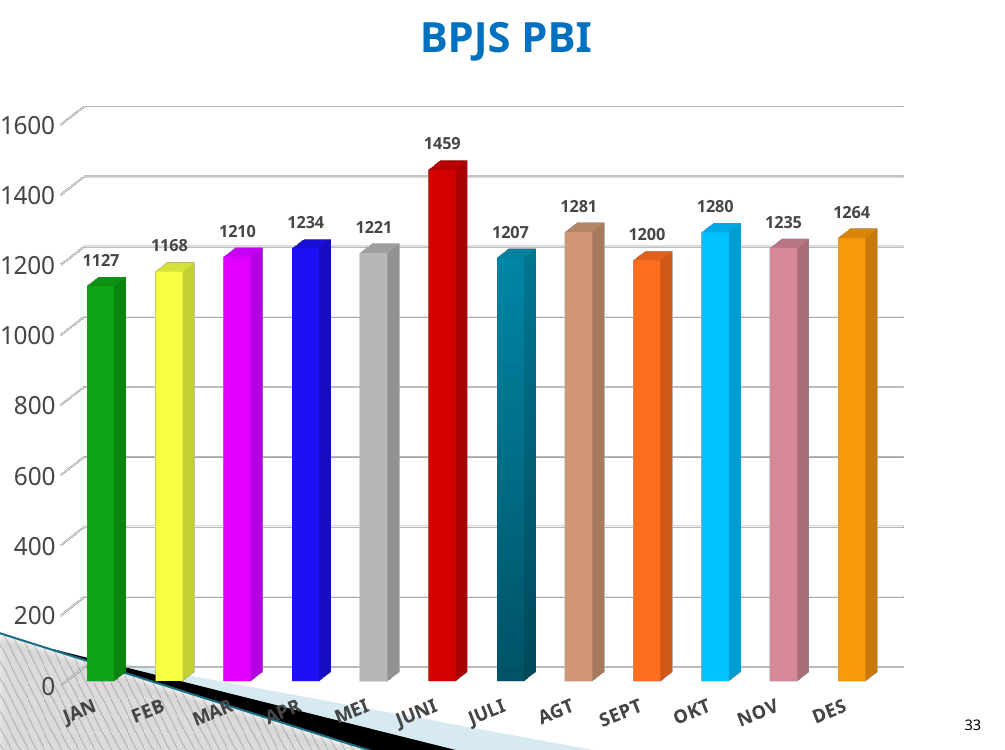
What is the difference between the values for JUNI and JAN? 332 Which month has the highest value? JUNI What is the difference between the values for DES and MAR? 54 Which is larger, the value for MAR or the value for DES? DES What is the value for SEPT? 1200 Which month has the lowest value? JAN What kind of chart is shown on the slide? bar chart What is the value for JUNI? 1459 How many months are shown on the x axis? 12 What is the title of the chart? BPJS PBI What is the value for DES? 1264 Is the value for JUNI greater or less than 1400? greater